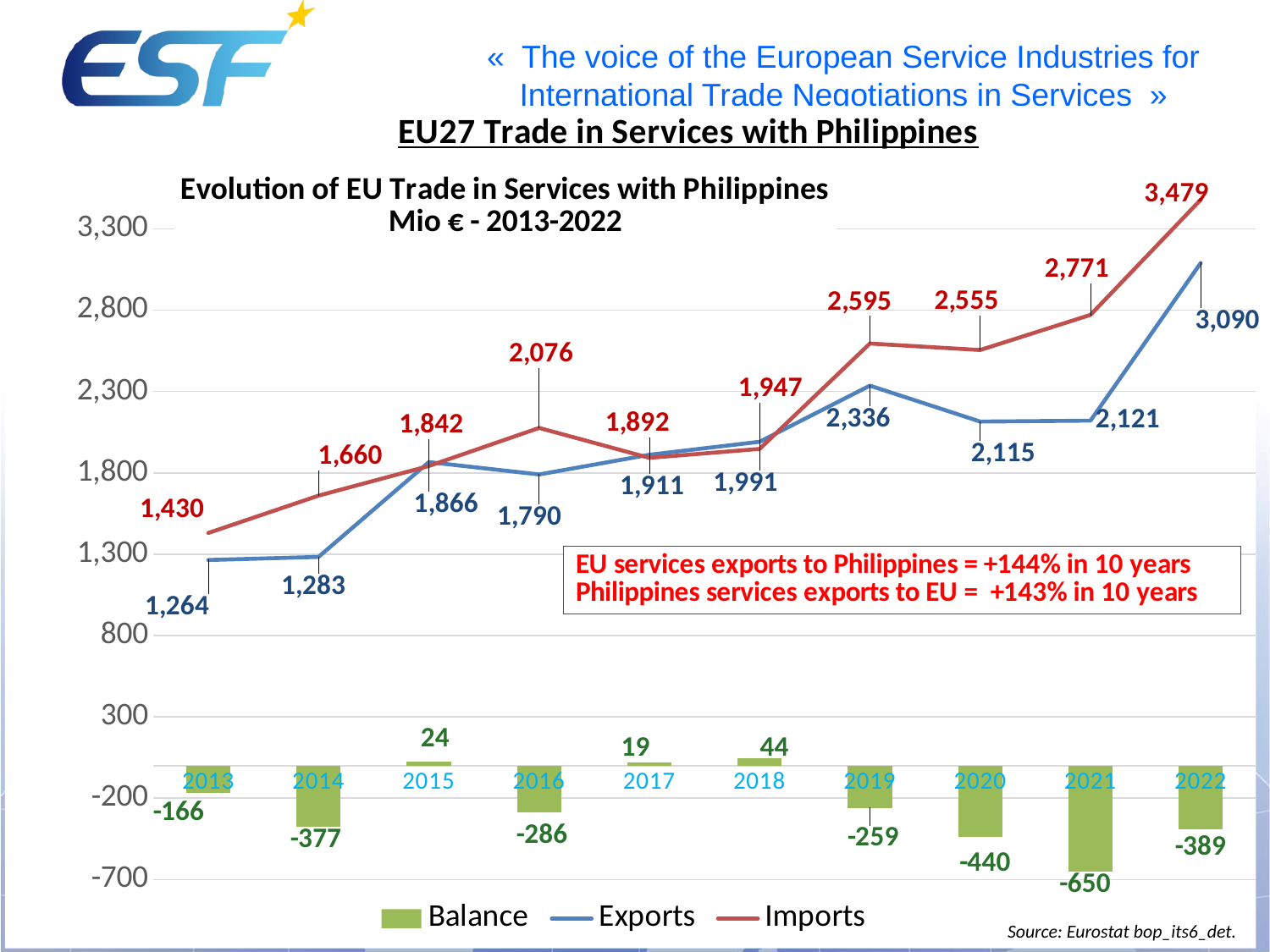
In which year are Exports highest? 2022 What is the title of the chart? Evolution of EU Trade in Services with Philippines Mio € - 2013-2022 How many years are shown on the x axis? 10 In 2015, which is larger, Exports or Imports? Exports In which year is the Balance lowest? 2021 What is the value of Imports in 2022? 3,479 How many series does the legend list? 3 Do Imports rise or fall from 2013 to 2016? Rise What is the Balance value shown for 2021? -650 What kind of chart is this? Combined line and bar chart What is the difference between Imports and Exports in 2022? 389 What is the value of Exports in 2013? 1,264